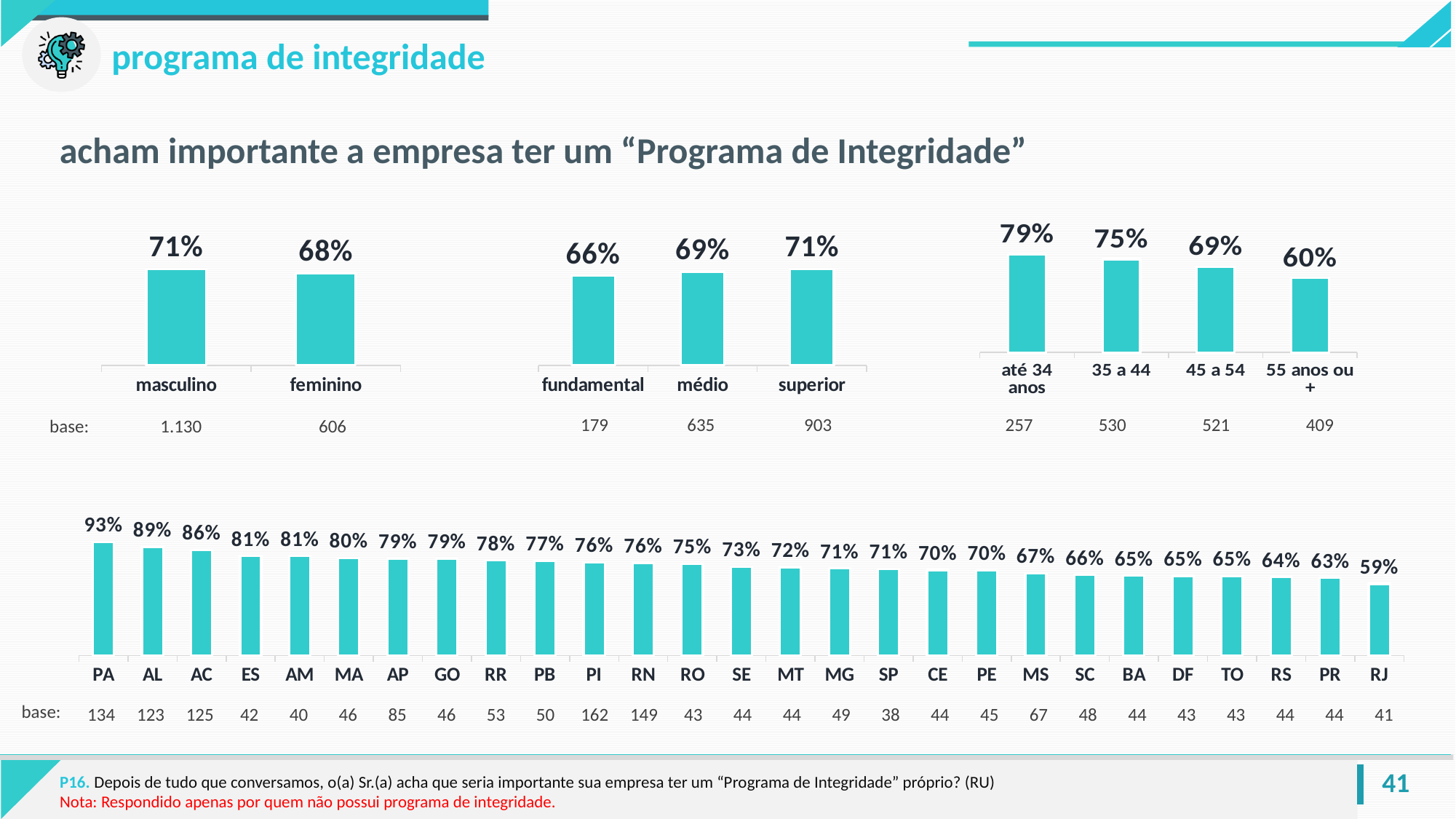
In the top-left chart (masculino/feminino), what is the value for masculino? 71% In the top-right chart (age groups), which age group has the highest value? até 34 anos In the top-middle chart (fundamental/médio/superior), what is the value for médio? 69% In the bottom chart (states), which state has the lowest value? RJ In the bottom chart (states), what is the value for SP? 71% In the top-right chart (age groups), do the values rise or fall from left to right? fall In the top-right chart (age groups), what is the value for 55 anos ou +? 60% In the top-left chart (masculino/feminino), what is the difference between masculino and feminino? 3% What kind of chart is the bottom chart (states)? bar chart In the bottom chart (states), how many states are shown? 27 In the bottom chart (states), which state has the highest value? PA In the top-middle chart (fundamental/médio/superior), which category has the lowest value? fundamental